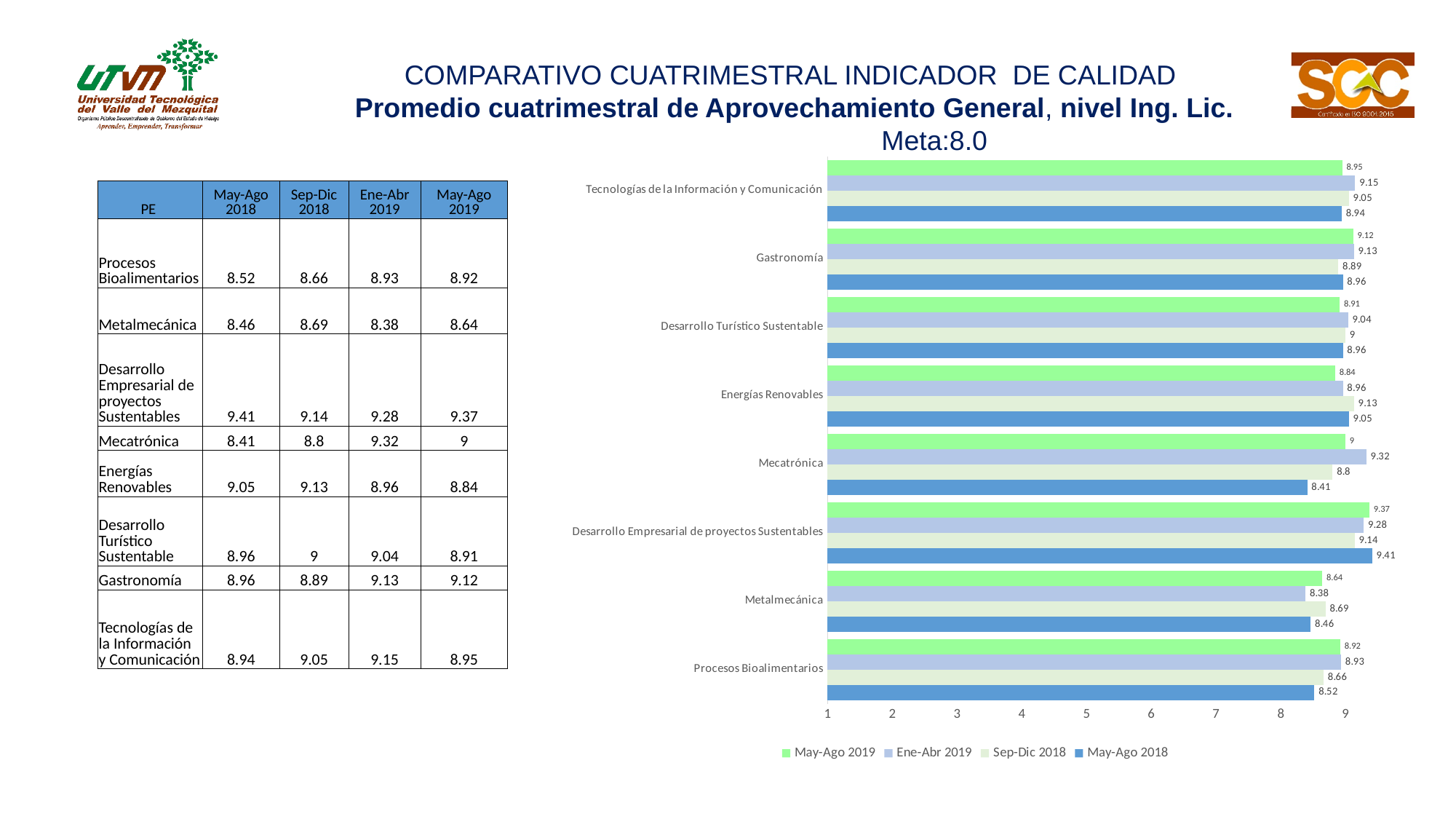
What is the May-Ago 2018 value for Mecatrónica in the chart? 8.41 What is the Sep-Dic 2018 value for Metalmecánica? 8.69 Which program has the highest May-Ago 2018 value? Desarrollo Empresarial de proyectos Sustentables What is the difference between the Ene-Abr 2019 and May-Ago 2018 values for Mecatrónica? 0.91 Which is larger for May-Ago 2019: Gastronomía or Energías Renovables? Gastronomía What kind of chart is shown on the slide? Bar chart Which program has the lowest Ene-Abr 2019 value? Metalmecánica How many programs (categories) are plotted in the chart? 8 What is the Ene-Abr 2019 value for Tecnologías de la Información y Comunicación? 9.15 Is the May-Ago 2019 value for Procesos Bioalimentarios greater or less than 8? greater How many series does the chart legend list? 4 What target (Meta) is stated in the chart title? 8.0